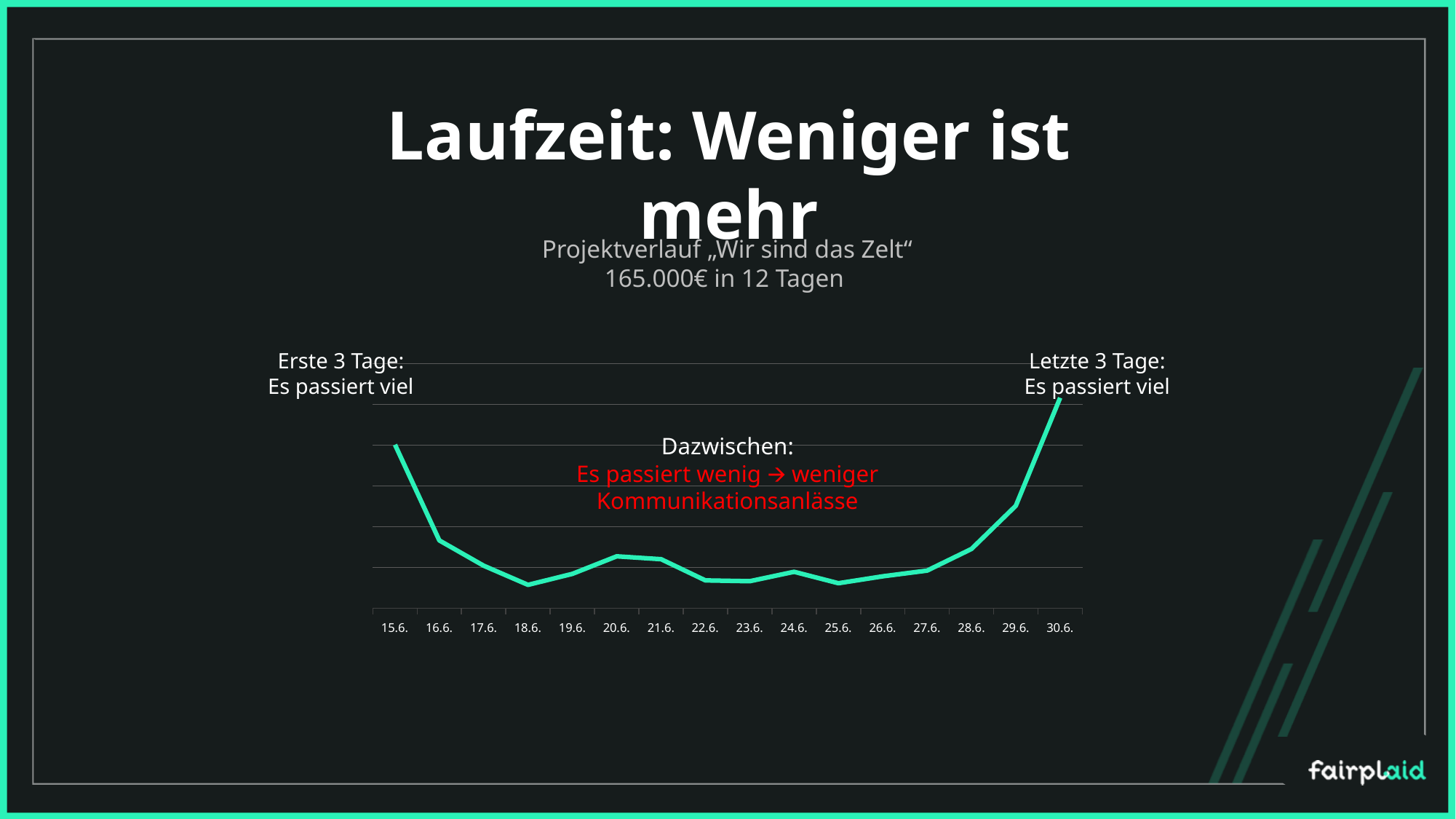
Does the line rise or fall from 27.6. to 30.6.? rise How many dates are shown on the x axis of the chart? 16 What is the first date label on the x axis of the chart? 15.6. What kind of chart is shown on the slide? line chart Which is higher on the chart, the value for 15.6. or the value for 20.6.? 15.6. On which date does the line reach its highest point? 30.6. Which is higher on the chart, the value for 16.6. or the value for 17.6.? 16.6. What is the title of the slide containing the chart? Laufzeit: Weniger ist mehr Which is higher on the chart, the value for 29.6. or the value for 28.6.? 29.6. Does the line rise or fall from 15.6. to 18.6.? fall